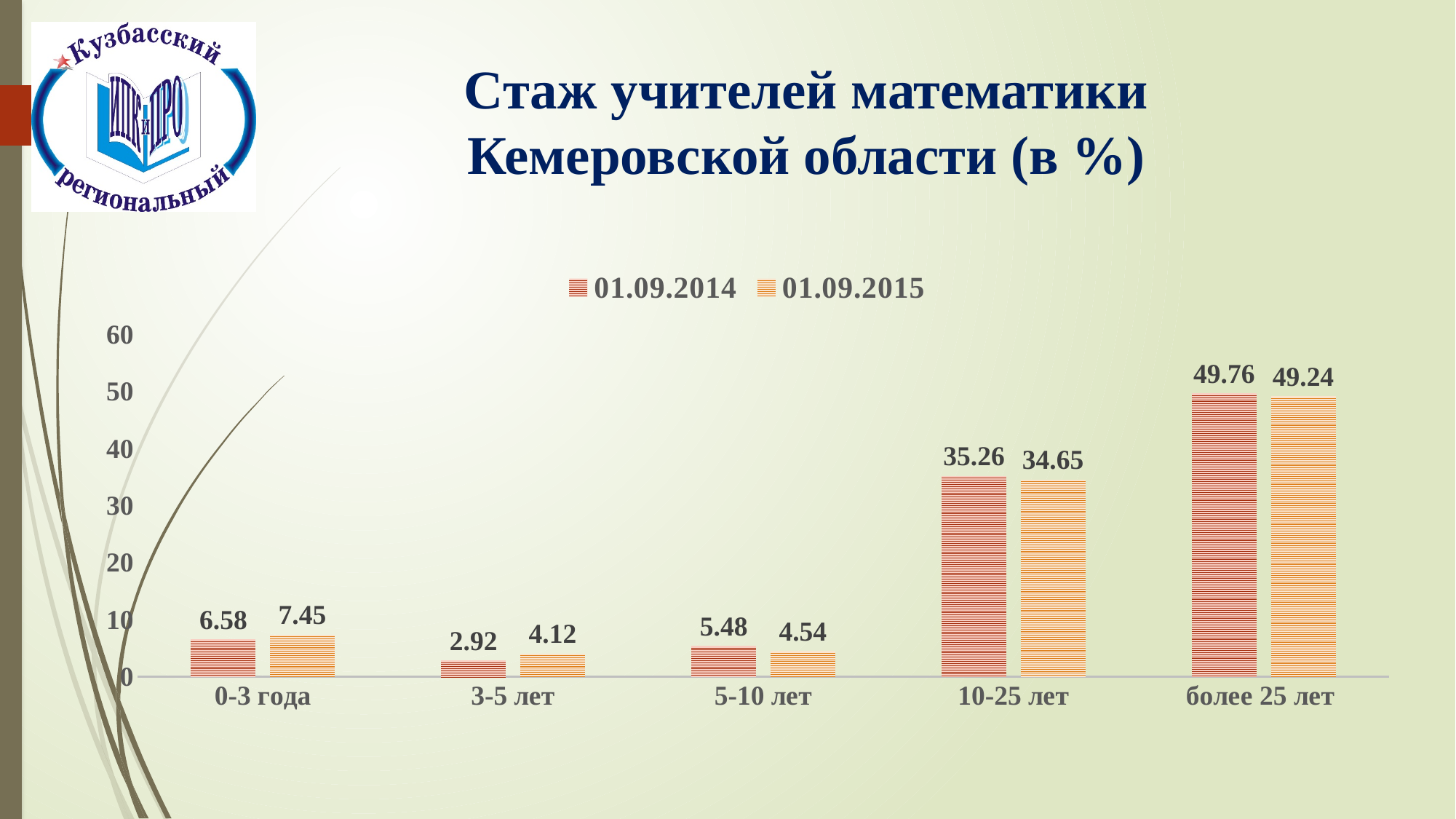
What kind of chart is shown on the slide? bar chart Which category has the highest value in the 01.09.2014 series? более 25 лет What is the value for более 25 лет in the 01.09.2015 series? 49.24 For 5-10 лет, which series has the larger value, 01.09.2014 or 01.09.2015? 01.09.2014 What is the title of the chart on the slide? Стаж учителей математики Кемеровской области (в %) What is the value for 3-5 лет in the 01.09.2015 series? 4.12 What is the value for 0-3 года in the 01.09.2014 series? 6.58 How many series does the legend list? 2 What is the value for 10-25 лет in the 01.09.2014 series? 35.26 How many categories are shown on the x axis? 5 What is the difference between the 01.09.2014 and 01.09.2015 values for 10-25 лет? 0.61 Which category has the lowest value in the 01.09.2015 series? 3-5 лет